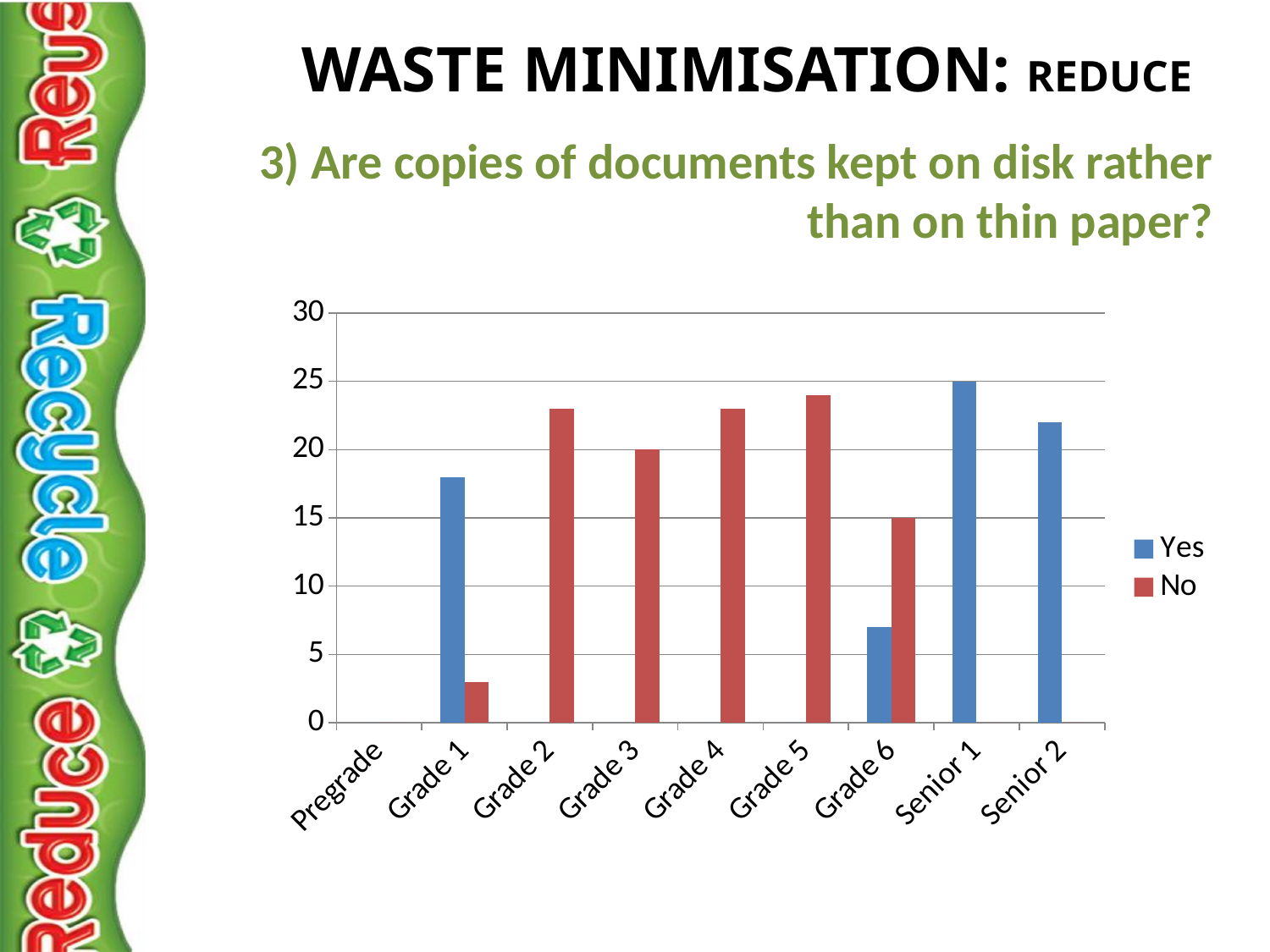
What is the value of the Yes bar for Senior 1? 25 How many series does the legend list? 2 Is the Yes value for Grade 1 greater or less than 15? greater Is the Yes value for Grade 6 greater or less than 10? less What kind of chart is shown on the slide? bar chart Which category has the highest Yes bar? Senior 1 What is the value of the No bar for Grade 6? 15 What is the value of the No bar for Grade 3? 20 For Grade 1, which is larger, the Yes bar or the No bar? Yes Among the categories with a No bar, which has the lowest No value? Grade 1 Which colour represents the Yes series in the legend? blue How many categories are shown on the x axis? 9